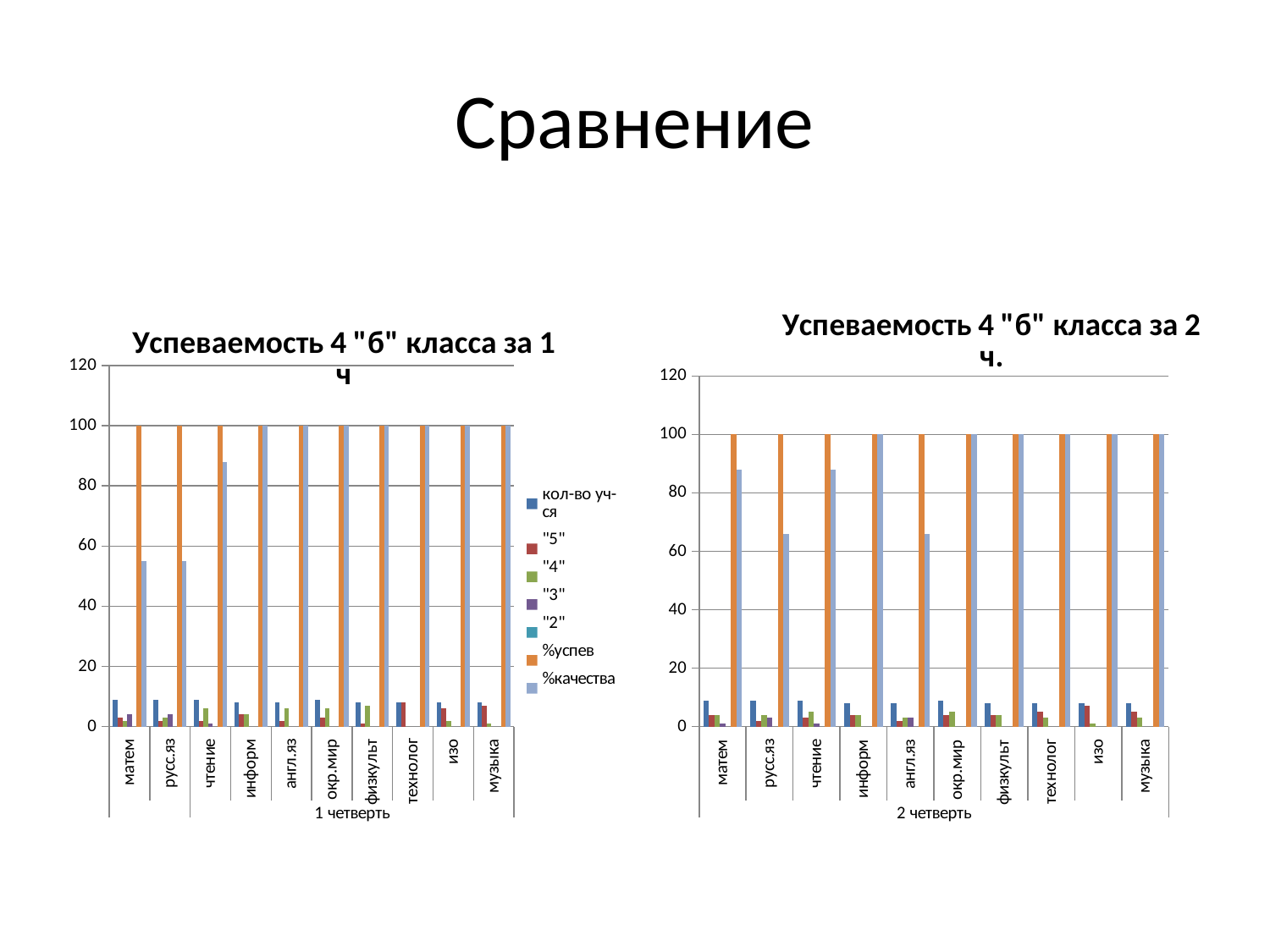
In the left chart (1 четверть), is the %качества value for чтение greater or less than 80? greater In the left chart (1 четверть), which has the larger %качества value, русс.яз or информ? информ How many series does the legend of the left chart list? 7 In the right chart (2 четверть), is the %качества value for русс.яз greater or less than 80? less What is the title of the right chart? Успеваемость 4 "б" класса за 2 ч. How many subject categories are shown on the x axis of the right chart (2 четверть)? 10 In the left chart (1 четверть), what is the %успев value for матем? 100 In the left chart (1 четверть), is the %качества value for матем greater or less than 80? less How many subject categories are shown on the x axis of the left chart (1 четверть)? 10 In the right chart (2 четверть), which has the larger %качества value, матем or русс.яз? матем What kind of chart is the left chart, "Успеваемость 4 "б" класса за 1 ч"? bar chart